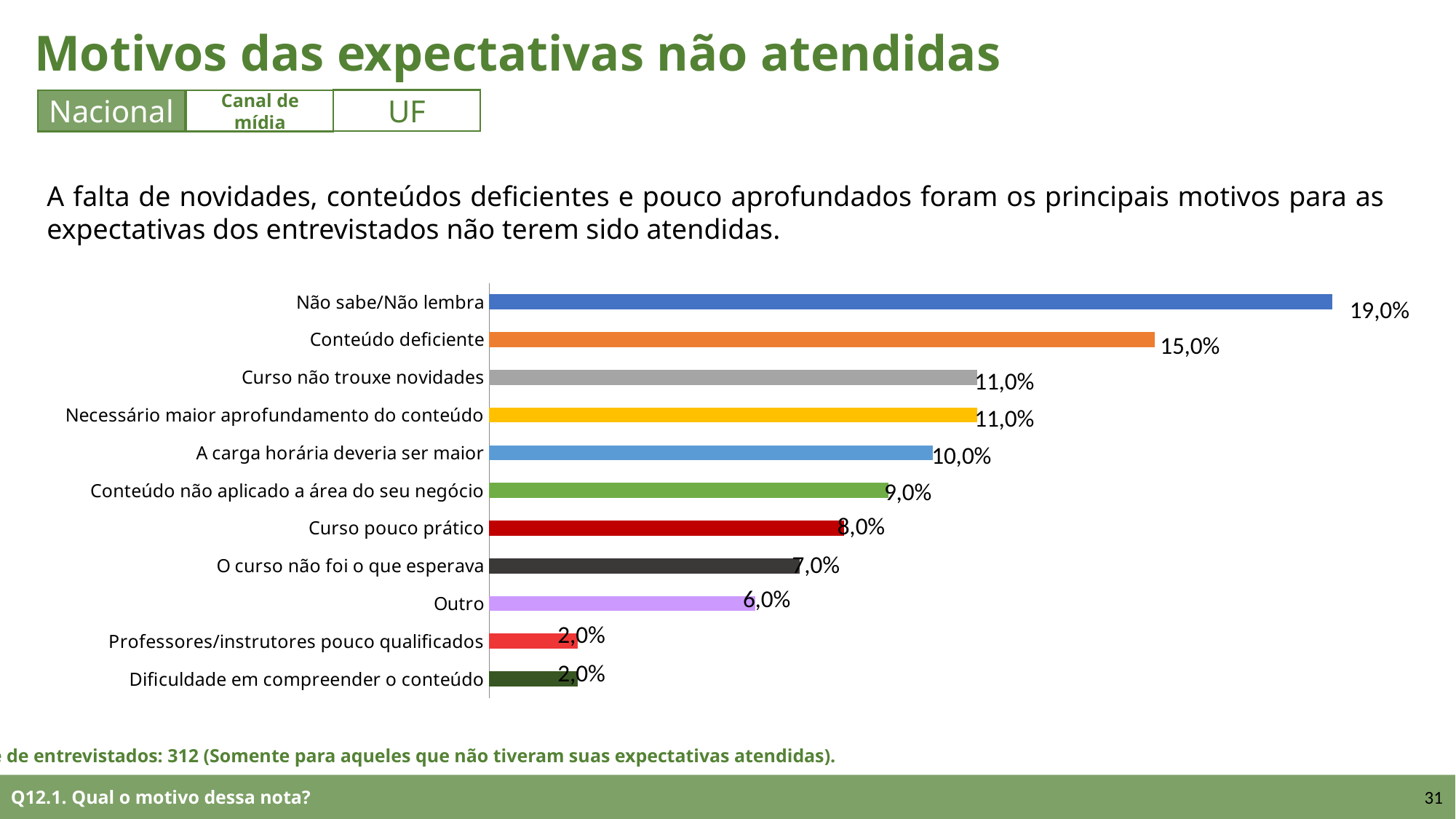
What is the difference between "Curso pouco prático" and "O curso não foi o que esperava"? 1,0% Which is larger, "Conteúdo não aplicado a área do seu negócio" or "Curso pouco prático"? Conteúdo não aplicado a área do seu negócio How many categories are shown in the chart? 11 What colour is the bar for "Conteúdo deficiente"? Orange What kind of chart is shown on the slide? Bar chart What is the value for "Outro"? 6,0% Which two categories share the value 11,0%? Curso não trouxe novidades and Necessário maior aprofundamento do conteúdo What is the value for "A carga horária deveria ser maior"? 10,0% What is the value for "Conteúdo deficiente"? 15,0% What is the value for "Professores/instrutores pouco qualificados"? 2,0% What is the difference between "Não sabe/Não lembra" and "Conteúdo deficiente"? 4,0% Which category has the highest value? Não sabe/Não lembra